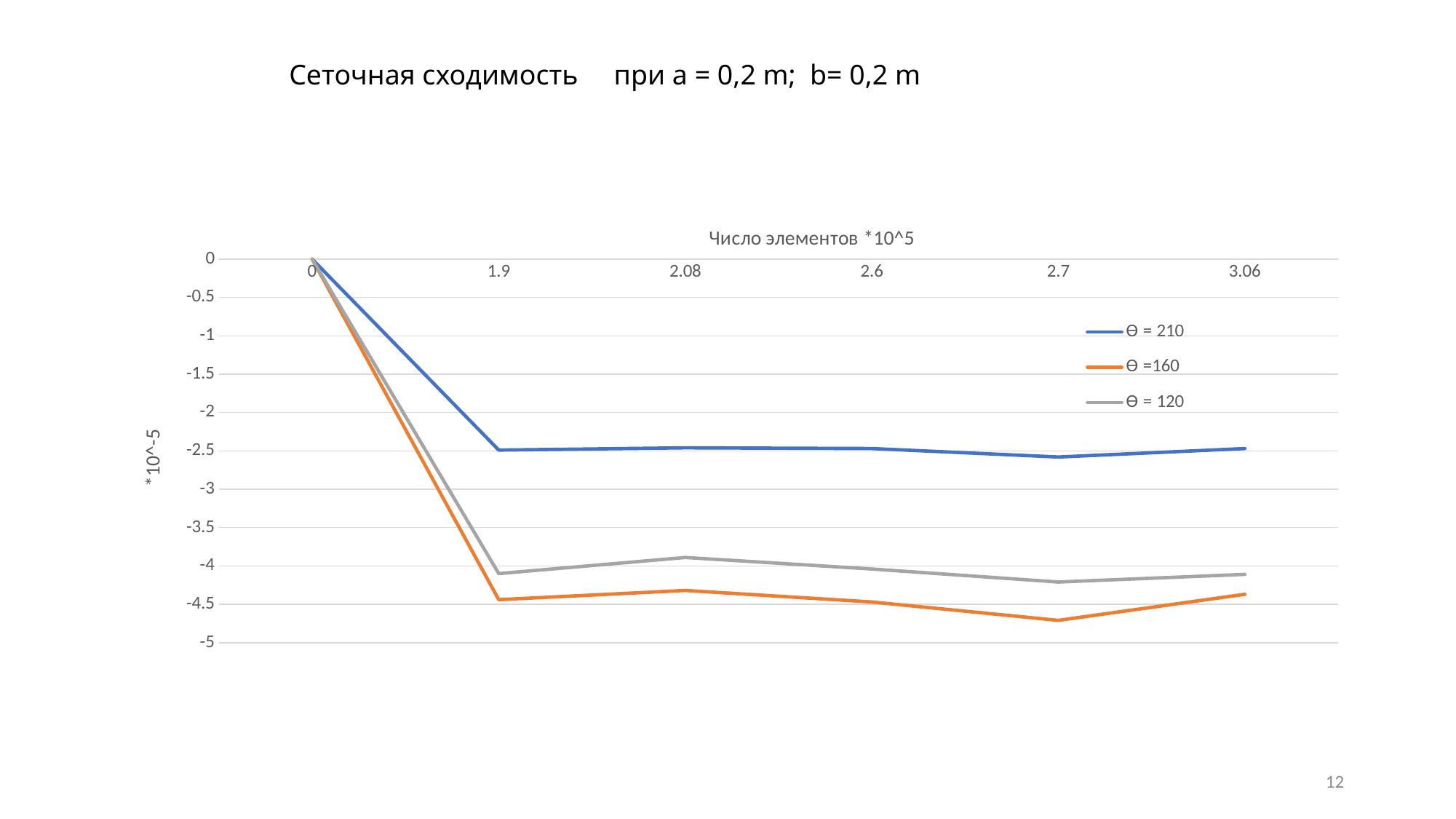
What is the title of the x axis? Число элементов *10^5 Do the values of all three series rise or fall between x = 0 and x = 1.9? fall Is the value of the Ө = 120 series at x = 2.08 greater or less than -4? greater Which series is drawn in orange? Ө =160 How many points are marked along the x axis? 6 Is the value of the Ө = 210 series at x = 2.6 greater or less than -3? greater How many series does the legend list? 3 What kind of chart is shown on the slide? line chart What is the value of the Ө = 210 series at x = 0? 0 At x = 3.06, which series has the higher value, Ө = 210 or Ө =160? Ө = 210 Which series has the lowest values across the chart after x = 0? Ө =160 Is the value of the Ө =160 series at x = 2.7 greater or less than -4.5? less